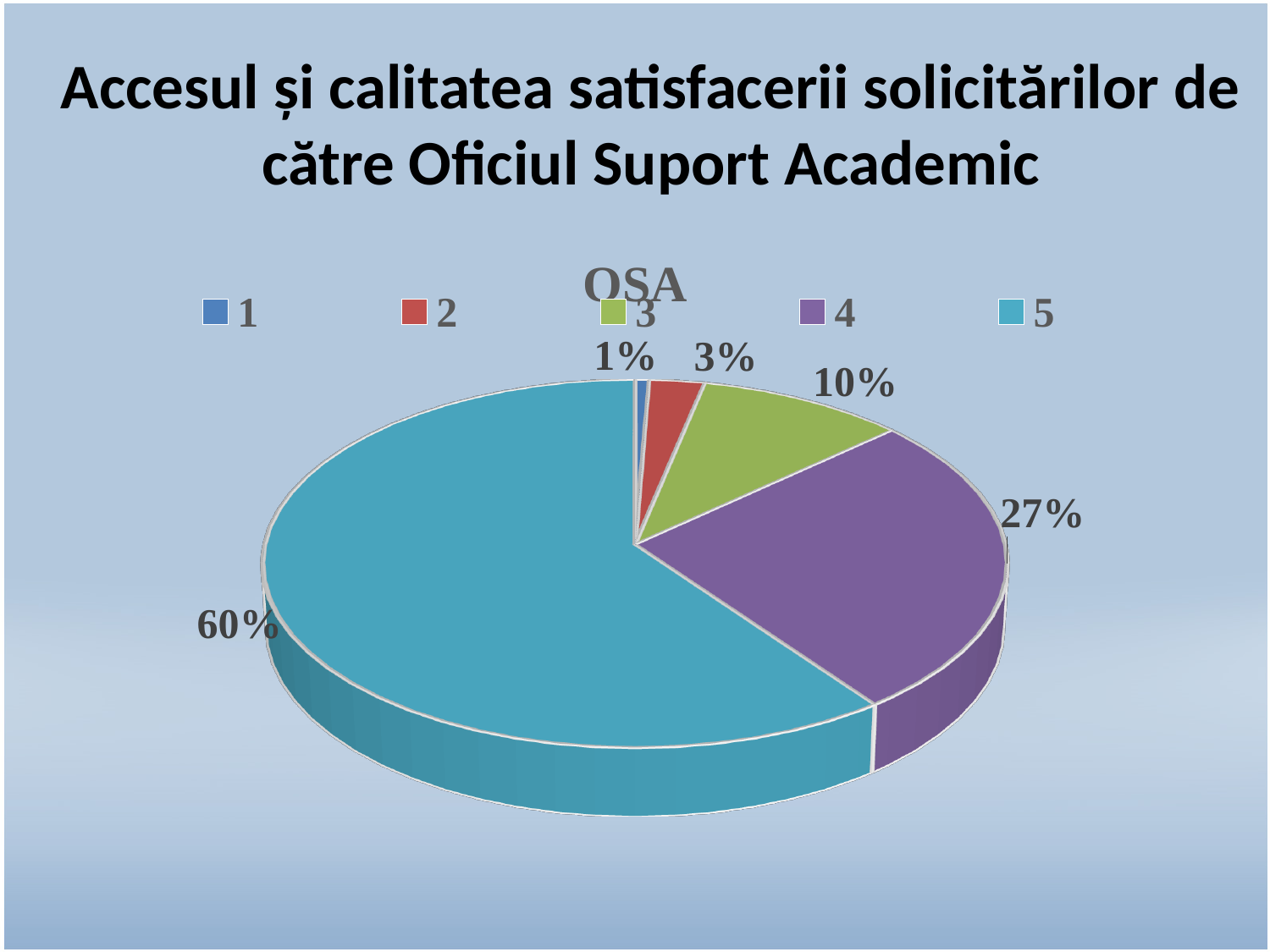
Which category has the largest slice? 5 How many categories does the legend list? 5 What share of the pie does category 2 have? 3% What is the chart's title? OSA What kind of chart is shown on the slide? pie chart What share of the pie does category 1 have? 1% Which category has the smallest slice? 1 What share of the pie does category 3 have? 10% What is the difference between the shares of category 5 and category 4? 33% Which is larger, the share of category 3 or the share of category 2? 3